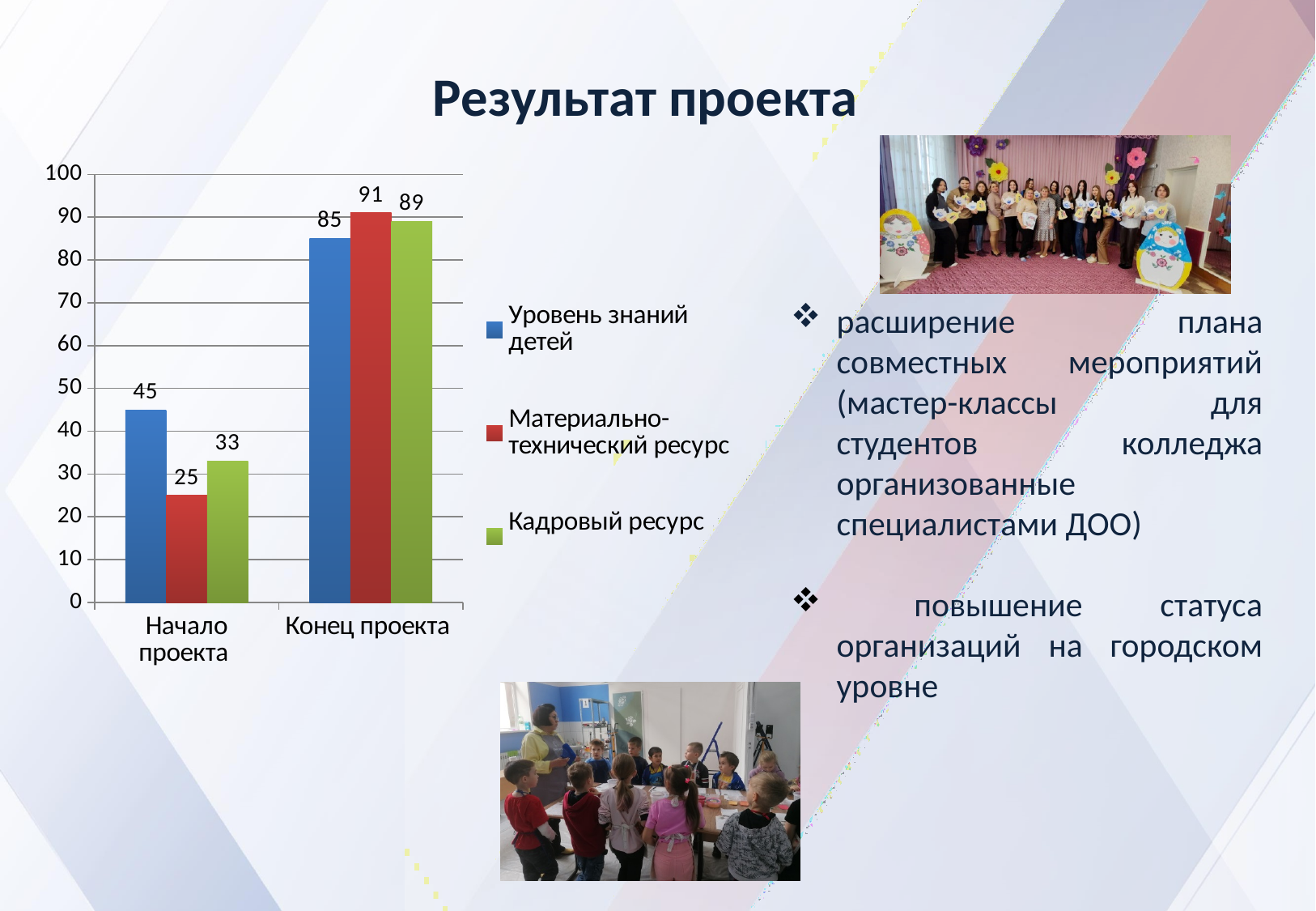
Which series has the highest value at Конец проекта? Материально-технический ресурс What colour are the bars for Кадровый ресурс? Green What is the value for Кадровый ресурс at Начало проекта? 33 What is the value for Материально-технический ресурс at Конец проекта? 91 How many series does the legend list? 3 Which is larger: Кадровый ресурс at Начало проекта or Материально-технический ресурс at Начало проекта? Кадровый ресурс at Начало проекта What is the value for Уровень знаний детей at Начало проекта? 45 What is the difference between the Уровень знаний детей values at Конец проекта and Начало проекта? 40 How many categories are shown on the x axis? 2 What kind of chart is shown on the slide? Bar chart Do the values for Материально-технический ресурс rise or fall from Начало проекта to Конец проекта? Rise Which series has the lowest value at Начало проекта? Материально-технический ресурс